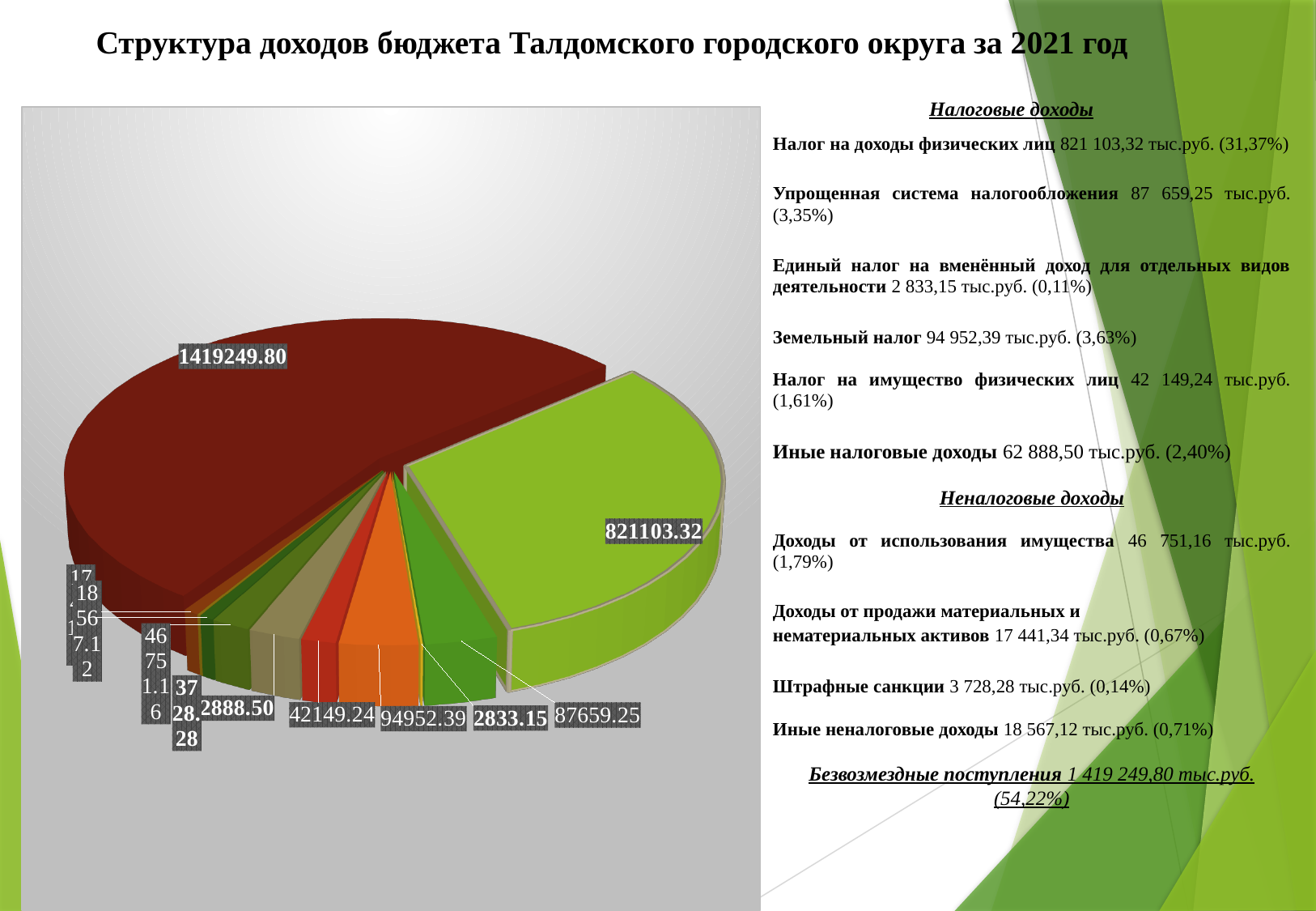
What kind of chart is shown on the slide? pie chart What is the title of the slide containing the pie chart? Структура доходов бюджета Талдомского городского округа за 2021 год According to the slide, what value does the pie chart show for Земельный налог? 94952.39 What is the difference between the slice labelled 1419249.80 and the slice labelled 821103.32? 598146.48 What is the value shown on the light green slice of the pie chart (the second largest)? 821103.32 What share of the pie does the largest slice (Безвозмездные поступления) represent, according to the slide? 54,22% What colour is the largest slice of the pie chart? dark red Which is larger in the pie chart: the slice labelled 821103.32 or the slice labelled 87659.25? 821103.32 What is the value shown on the largest slice of the pie chart? 1419249.80 According to the slide, what value does the pie chart show for Упрощенная система налогообложения? 87659.25 According to the slide, what value does the pie chart show for Налог на имущество физических лиц? 42149.24 According to the slide, what value does the pie chart show for Единый налог на вменённый доход? 2833.15